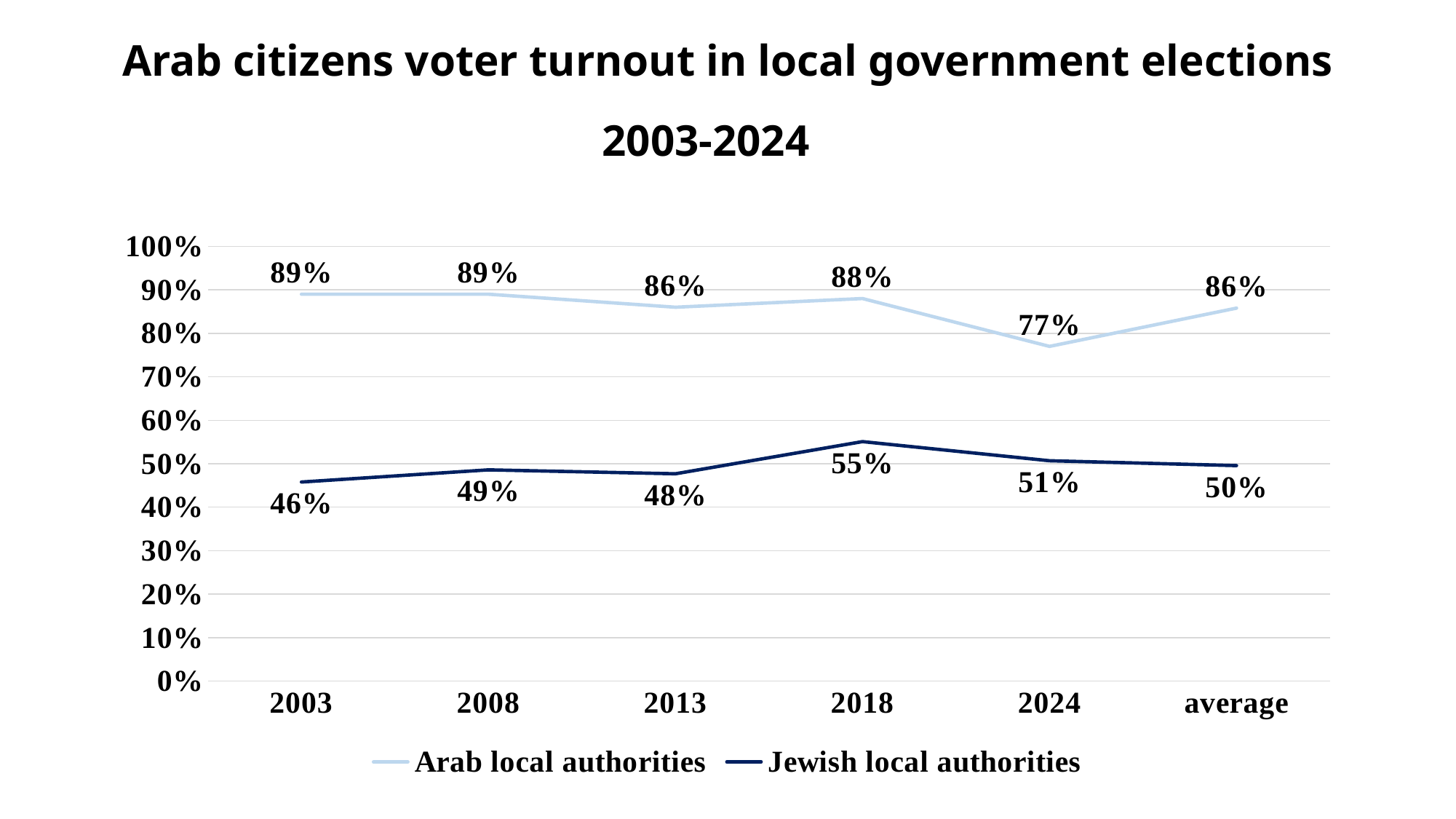
How many series does the legend list? 2 What is the difference between Arab local authorities and Jewish local authorities turnout in 2003? 43 percentage points In which year was the voter turnout for Arab local authorities lowest? 2024 What was the voter turnout for Jewish local authorities in 2018? 55% What is the average voter turnout for Jewish local authorities? 50% How many points are shown on the x axis? 6 What kind of chart is shown on the slide? Line chart Did the turnout for Arab local authorities rise or fall from 2018 to 2024? Fall In which year was the voter turnout for Jewish local authorities highest? 2018 What was the voter turnout for Arab local authorities in 2024? 77% Is the 2018 value for Jewish local authorities greater or less than 50%? greater Which had higher turnout in 2013, Arab local authorities or Jewish local authorities? Arab local authorities